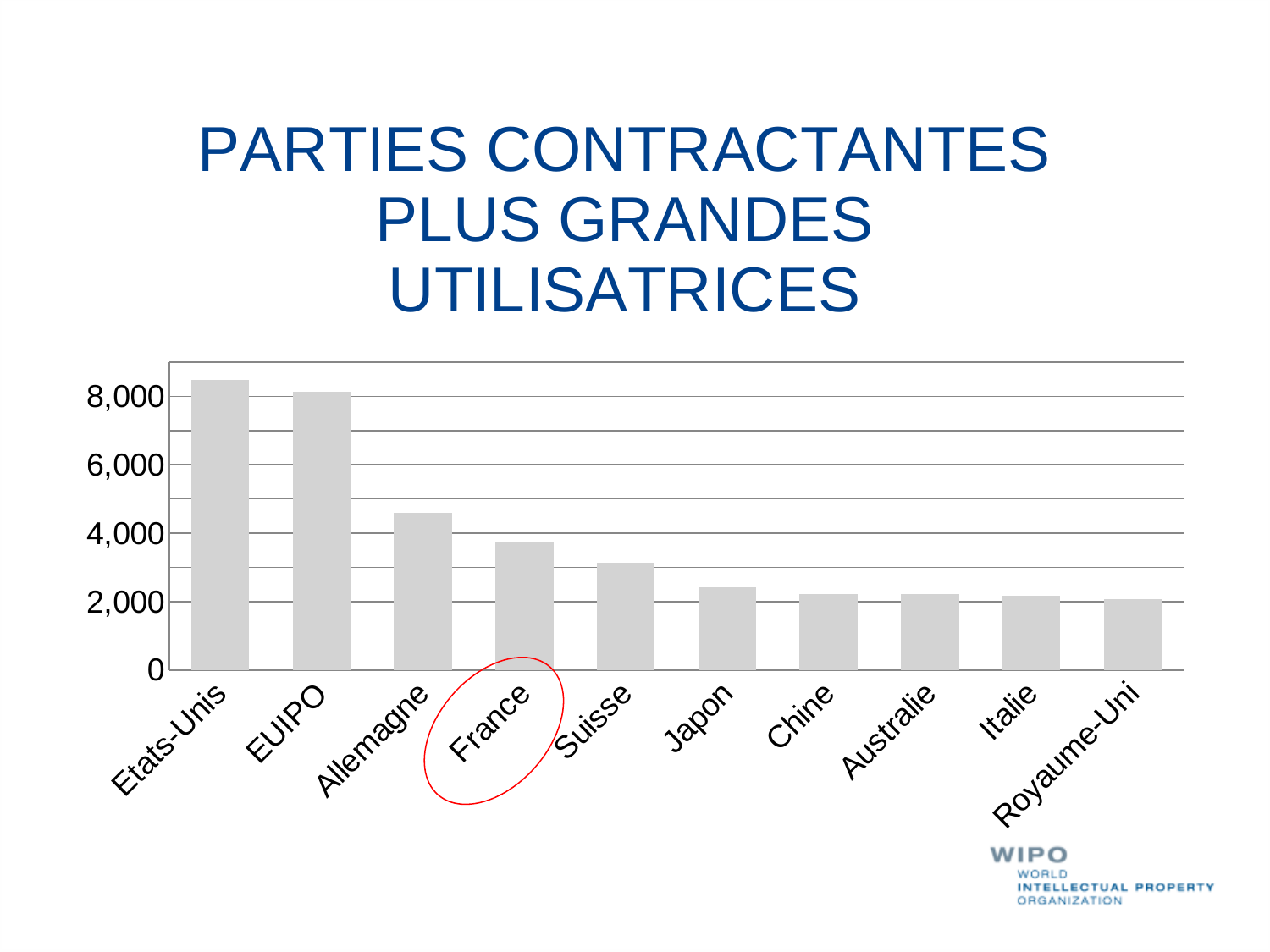
Is the value for France greater or less than 4,000? less Which category label on the x axis is circled in red? France Is the value for Allemagne greater or less than 4,000? greater Do the bar values rise or fall from left to right along the x axis? fall Is the value for Suisse greater or less than 4,000? less How many categories are shown on the x axis of the chart? 10 Which has a larger value, Allemagne or France? Allemagne What kind of chart is shown on the slide? bar chart Which has a larger value, Etats-Unis or EUIPO? Etats-Unis Which category has the highest bar in the chart? Etats-Unis